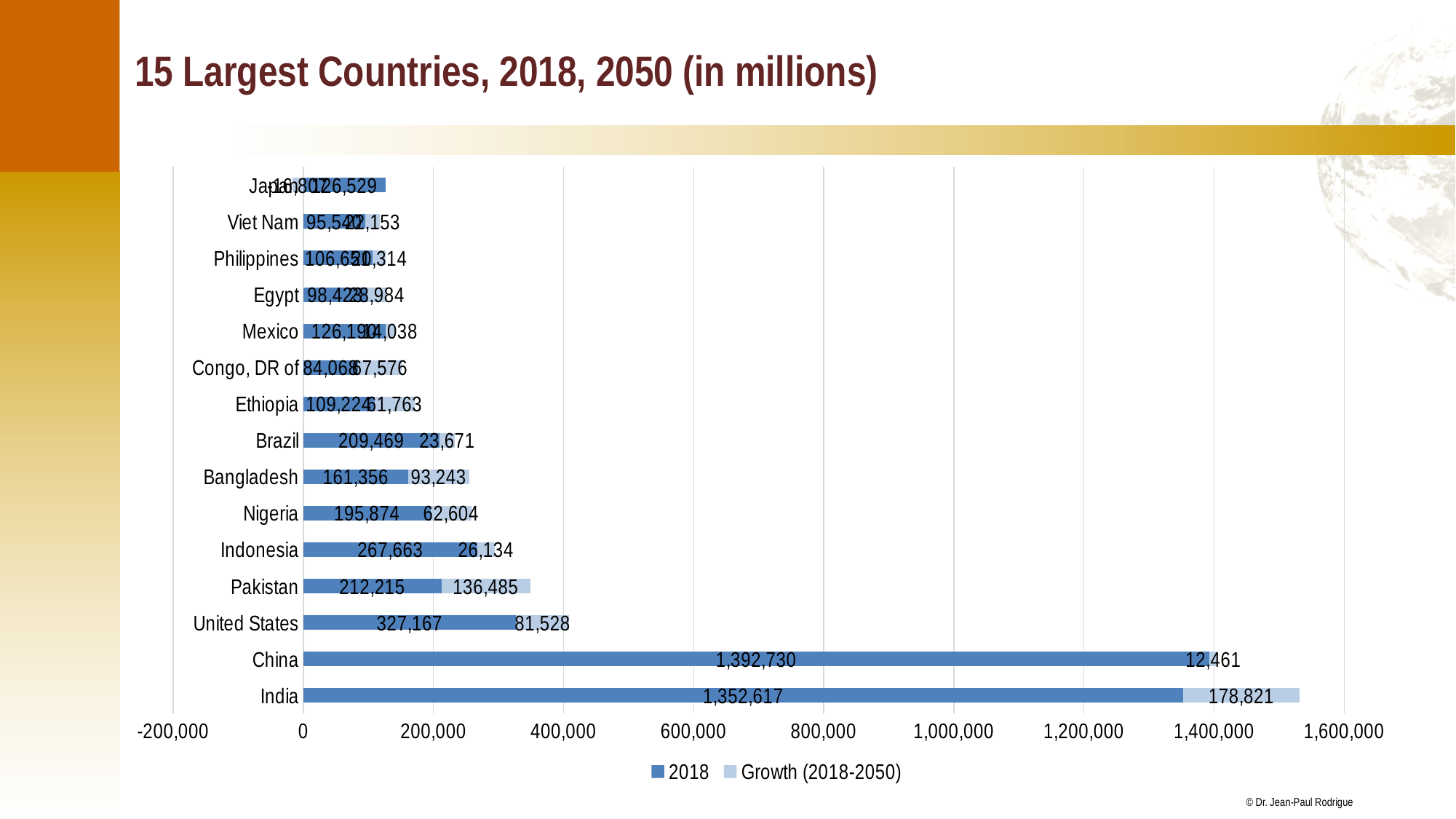
What is the difference between the 2018 values for China and India? 40,113 How many countries are plotted in the chart? 15 What are the two legend entries of the chart? 2018 and Growth (2018-2050) What is the Growth (2018-2050) value for Pakistan? 136,485 Which is larger, the Growth (2018-2050) value for Pakistan or for the United States? Pakistan What is the 2018 value for India? 1,352,617 Which country has the highest 2018 value? China Which country has the largest Growth (2018-2050) value? India How many series does the legend list? 2 What is the total of the stacked bar for India (2018 plus Growth 2018-2050)? 1,531,438 What is the 2018 value for Nigeria? 195,874 What kind of chart is shown on the slide? bar chart